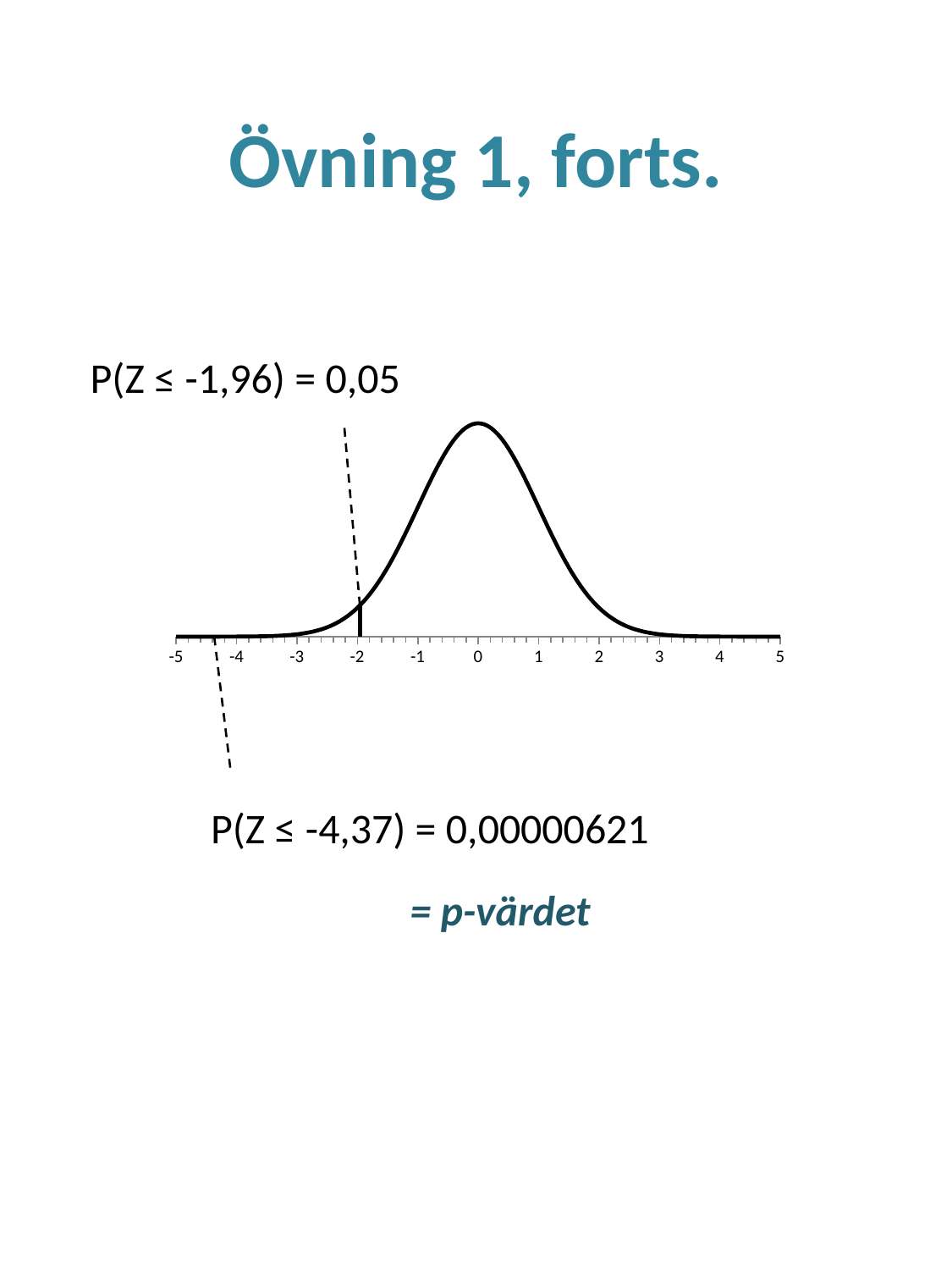
Is the curve higher at x = -1 or at x = -3? -1 According to the annotation, what is P(Z ≤ -4,37)? 0,00000621 What is the lowest value labelled on the x axis? -5 What is the highest value labelled on the x axis? 5 Does the curve rise or fall as x goes from -5 to 0? rise Does the curve rise or fall as x goes from 0 to 5? fall According to the annotation, what is P(Z ≤ -1,96)? 0,05 What kind of chart is shown on the slide? line chart At which x-axis value does the curve reach its highest point? 0 Near which x-axis tick is the vertical solid line drawn under the curve? -2 How many tick labels are shown on the x axis? 11 Is the curve higher at x = 2 or at x = 0? 0